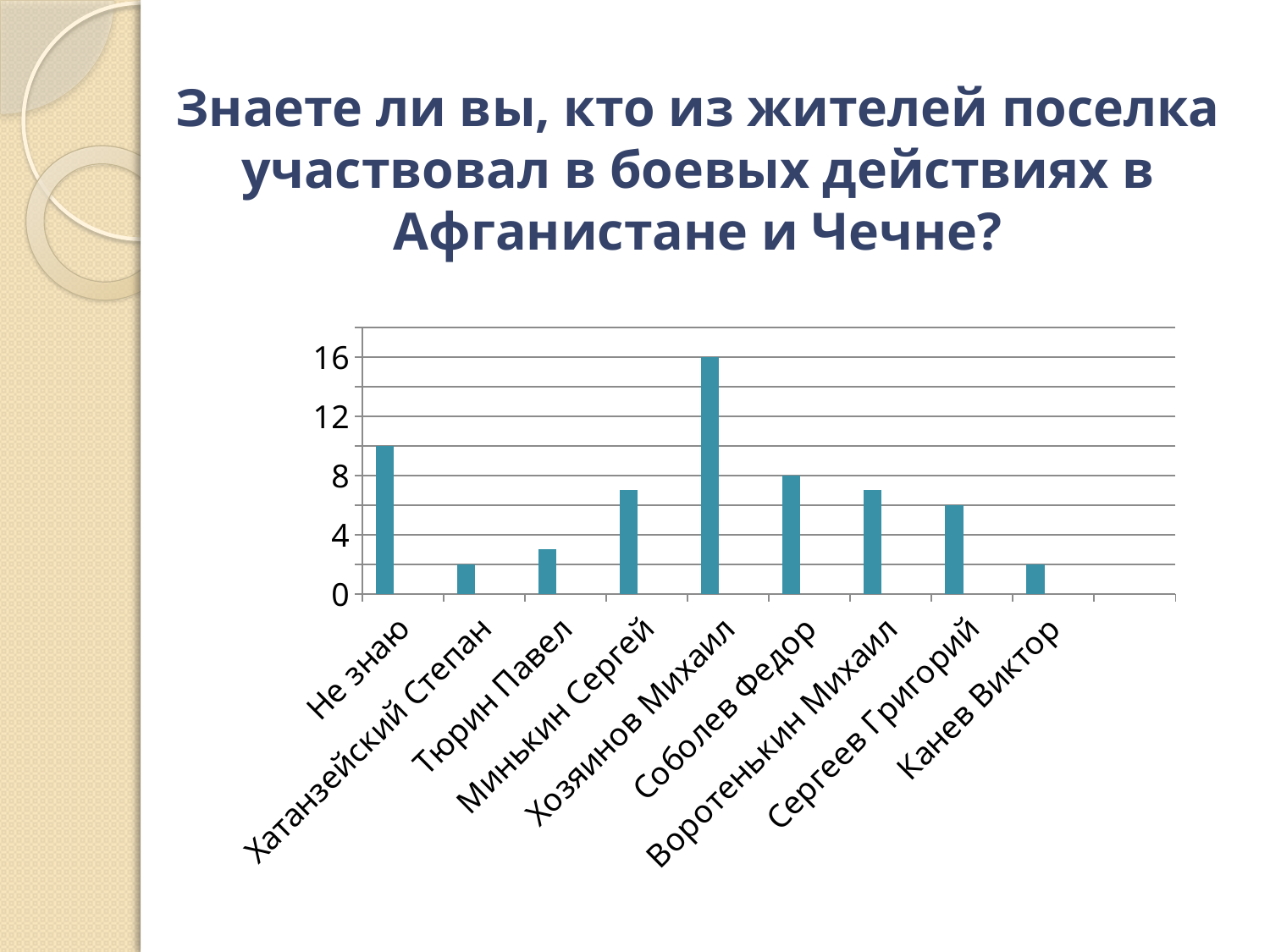
Is the value for Минькин Сергей greater or less than 4? greater Is the value for Не знаю greater or less than 8? greater How many categories are shown on the x axis of the chart? 9 What is the value for Хозяинов Михаил? 16 Which category has the highest value in the chart? Хозяинов Михаил Is the value for Хатанзейский Степан greater or less than 4? less Which is larger, the value for Не знаю or the value for Соболев Федор? Не знаю What is the difference between the values for Хозяинов Михаил and Соболев Федор? 8 What is the highest value labelled on the vertical axis of the chart? 16 What is the value for Соболев Федор? 8 What type of chart is shown on the slide? bar chart